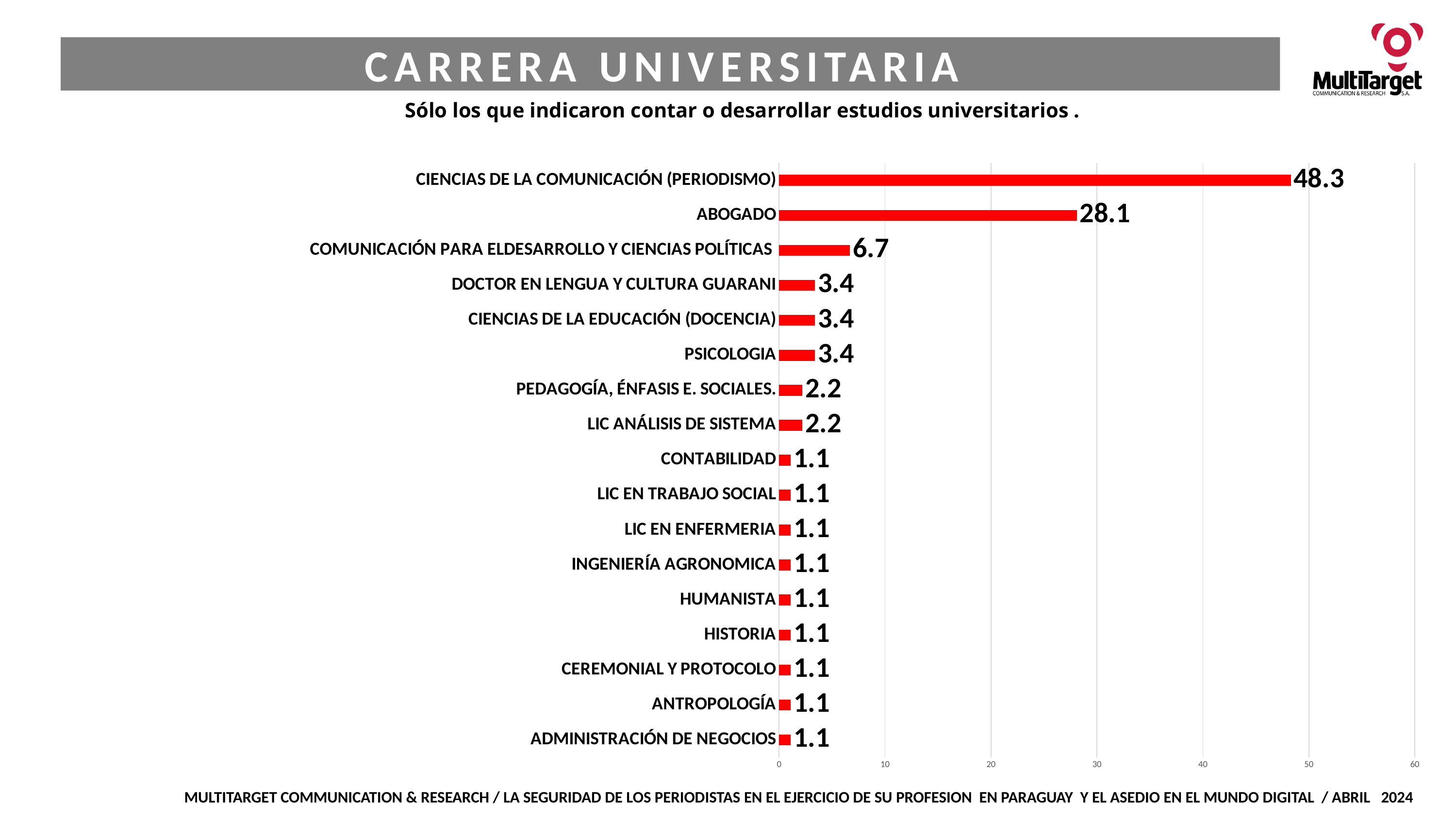
What kind of chart is shown on the slide? bar chart How many categories are shown in the chart? 17 What is the difference between the values for ABOGADO and COMUNICACIÓN PARA EL DESARROLLO Y CIENCIAS POLÍTICAS? 21.4 What is the value for LIC ANÁLISIS DE SISTEMA? 2.2 Which is larger, the value for DOCTOR EN LENGUA Y CULTURA GUARANI or the value for PEDAGOGÍA, ÉNFASIS E. SOCIALES? DOCTOR EN LENGUA Y CULTURA GUARANI What is the difference between the values for CIENCIAS DE LA COMUNICACIÓN (PERIODISMO) and ABOGADO? 20.2 What is the value for ABOGADO? 28.1 Which category has the highest value? CIENCIAS DE LA COMUNICACIÓN (PERIODISMO) What is the value for COMUNICACIÓN PARA EL DESARROLLO Y CIENCIAS POLÍTICAS? 6.7 What is the value for PSICOLOGIA? 3.4 What is the value for CIENCIAS DE LA COMUNICACIÓN (PERIODISMO)? 48.3 Is the value for ABOGADO greater or less than 30? less